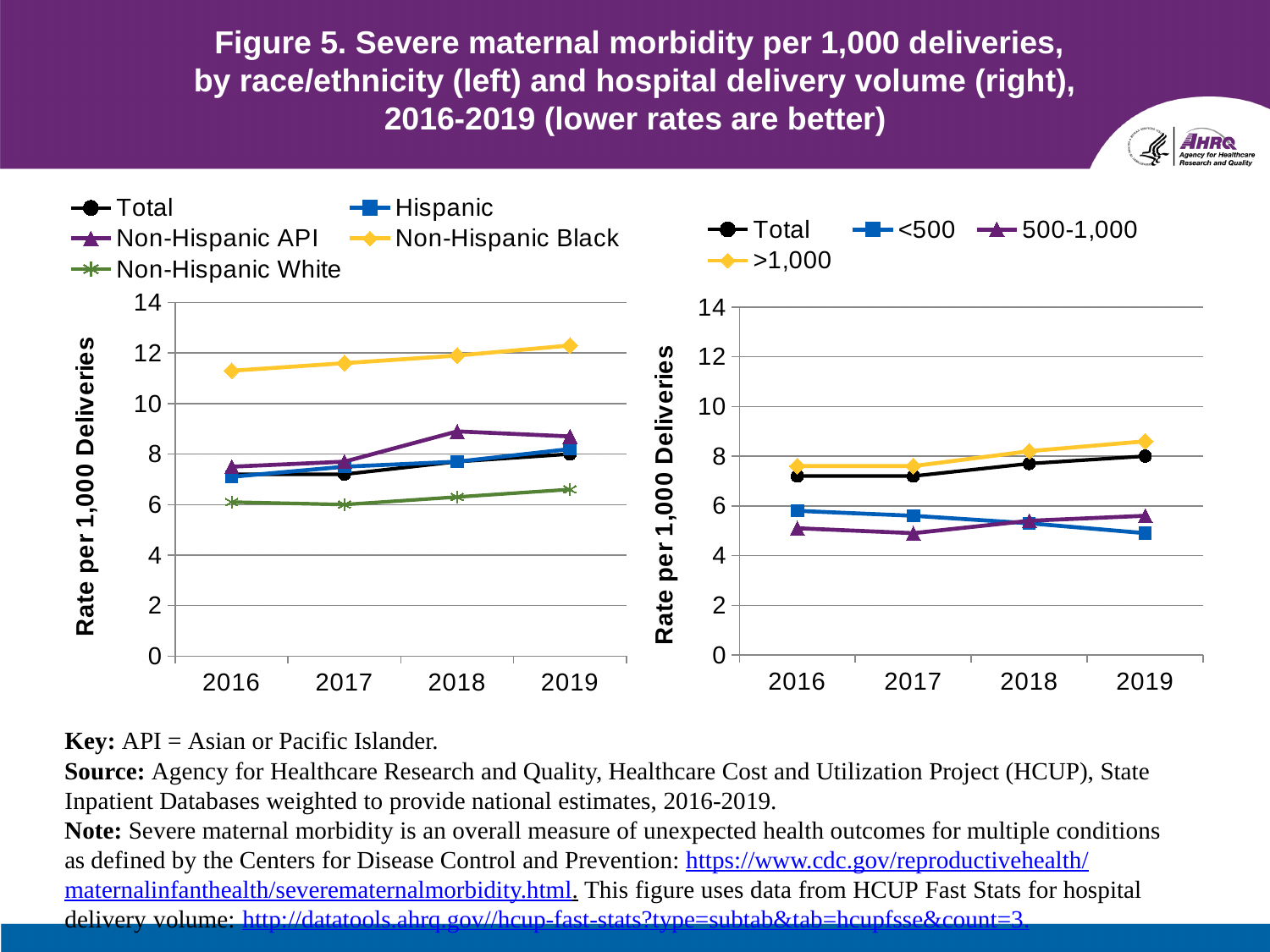
In the left chart (by race/ethnicity), is the value for Non-Hispanic White in 2017 greater or less than 8? less How many series does the legend of the left chart (by race/ethnicity) list? 5 In the right chart (by hospital delivery volume), does the rate for hospitals with <500 deliveries rise or fall from 2016 to 2019? fall In the left chart (by race/ethnicity), which series has the highest rate in 2019? Non-Hispanic Black How many series does the legend of the right chart (by hospital delivery volume) list? 4 In the right chart (by hospital delivery volume), which is larger in 2019: the rate for >1,000 or the rate for <500? >1,000 In the left chart (by race/ethnicity), which series has the lowest rate in 2016? Non-Hispanic White What kind of chart is the left chart (by race/ethnicity)? line chart How many years are shown on the x axis of the right chart (by hospital delivery volume)? 4 What is the y-axis title of the right chart (by hospital delivery volume)? Rate per 1,000 Deliveries In the left chart (by race/ethnicity), does the Non-Hispanic Black rate rise or fall from 2016 to 2019? rise In the left chart (by race/ethnicity), is the value for Non-Hispanic Black in 2019 greater or less than 10? greater